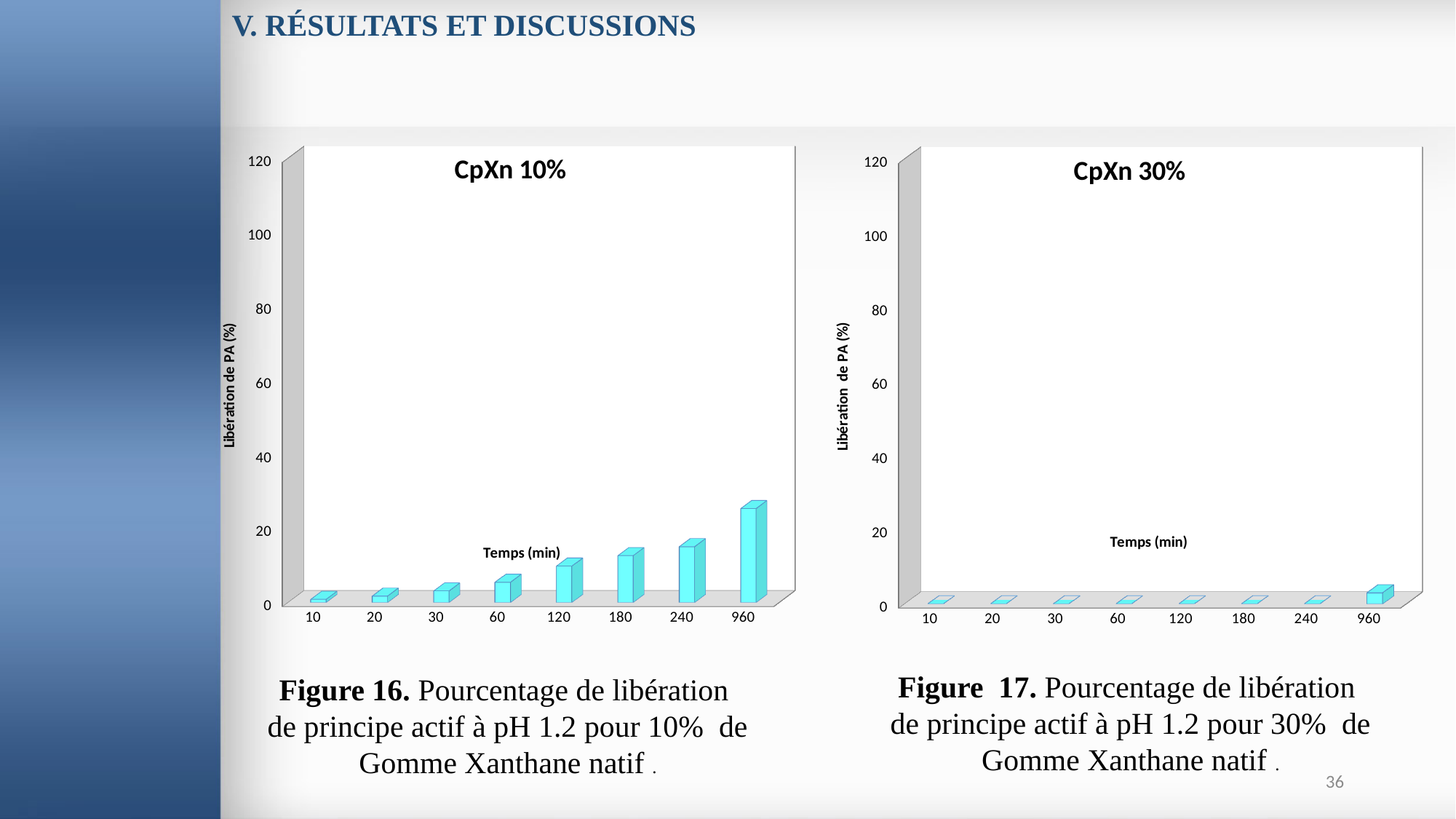
In the CpXn 10% chart, is the value at 960 min greater or less than 40? less In the CpXn 10% chart, which time point has the lowest release? 10 In the CpXn 10% chart, which time point has the highest release? 960 Which chart shows a larger value at 960 min, CpXn 10% or CpXn 30%? CpXn 10% In the CpXn 10% chart, is the value at 120 min greater or less than 20? less In the CpXn 10% chart, do the values rise or fall as time increases along the x axis? rise What is the y-axis label of the CpXn 10% chart? Libération de PA (%) What type of chart is the CpXn 10% chart? bar chart In the CpXn 30% chart, is the value at 960 min greater or less than 20? less In the CpXn 30% chart, which time point has the highest release? 960 How many time points are plotted in the CpXn 30% chart? 8